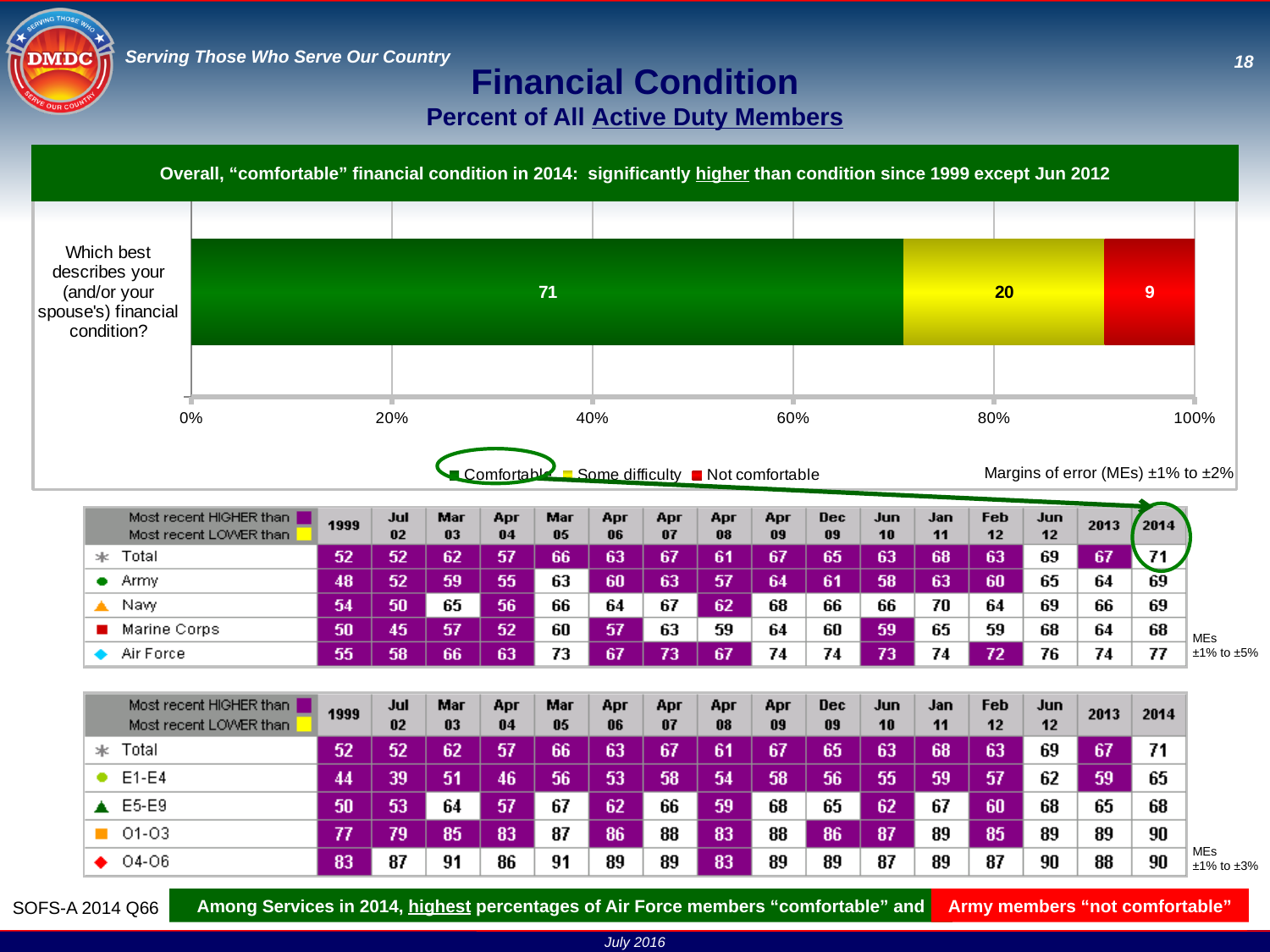
What type of chart is used to show the financial condition responses? Stacked bar chart What percentage of active duty members reported being "Comfortable" with their financial condition? 71 How many series does the chart legend list? 3 What percentage of active duty members reported "Some difficulty" with their financial condition? 20 Which response category has the smallest share of the bar? Not comfortable Which is larger, the "Some difficulty" share or the "Not comfortable" share? Some difficulty What margins of error are stated for the chart? ±1% to ±2% Which response category has the largest share of the bar? Comfortable What is the difference between the "Comfortable" and "Some difficulty" percentages? 51 What is the total of the three segments in the stacked bar? 100 What percentage of active duty members reported being "Not comfortable" with their financial condition? 9 What colour represents the "Comfortable" category in the chart? Green